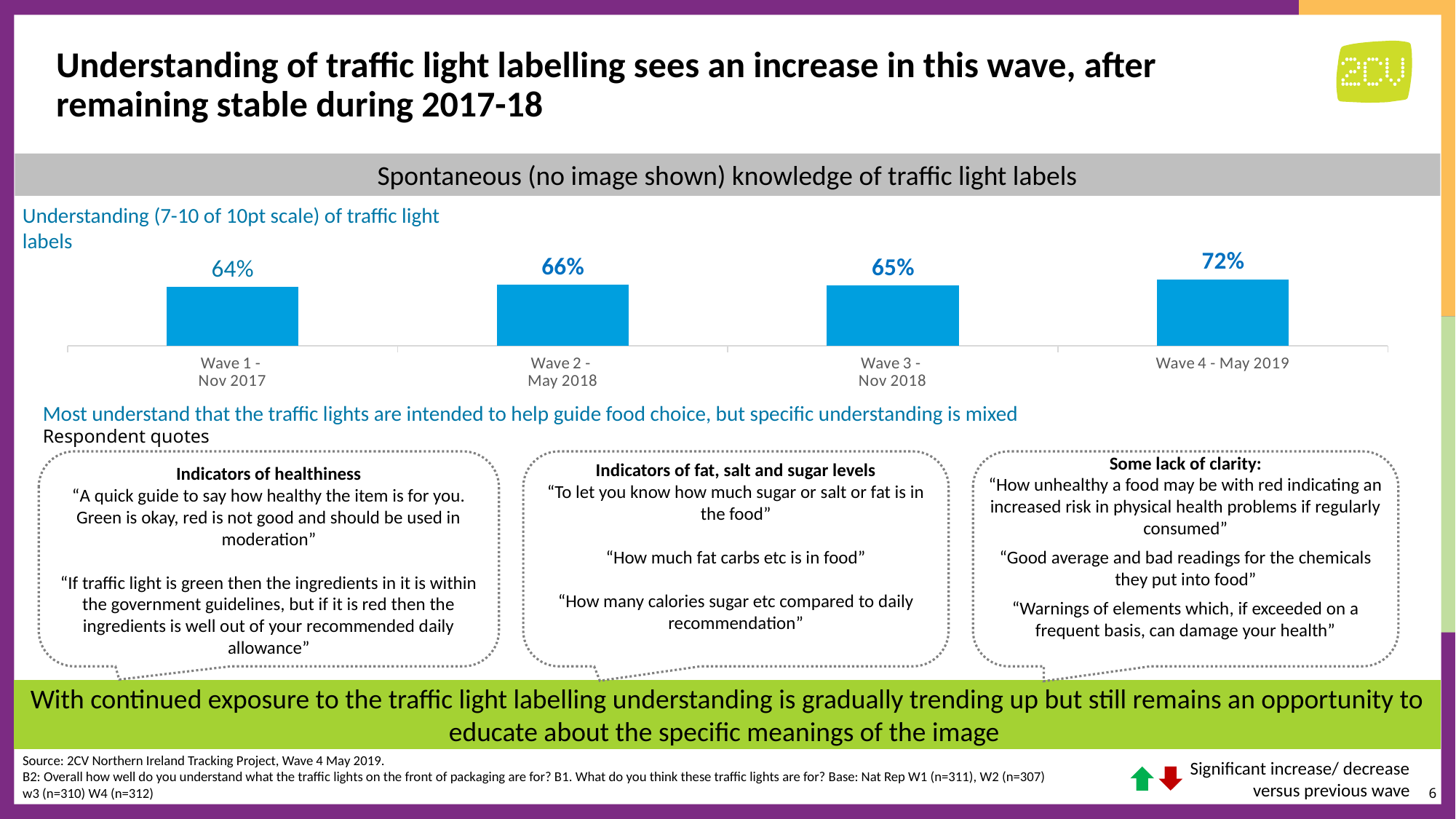
What is the difference between the values for Wave 2 - May 2018 and Wave 1 - Nov 2017? 2% Which is larger, the value for Wave 4 - May 2019 or Wave 1 - Nov 2017? Wave 4 - May 2019 What is the value for Wave 4 - May 2019? 72% What is the difference between the values for Wave 4 - May 2019 and Wave 3 - Nov 2018? 7% What is the value for Wave 2 - May 2018? 66% What is the value for Wave 1 - Nov 2017? 64% Which wave has the highest value? Wave 4 - May 2019 Which wave has the lowest value? Wave 1 - Nov 2017 What is the value for Wave 3 - Nov 2018? 65% What is the subtitle of the chart shown in blue above the bars? Understanding (7-10 of 10pt scale) of traffic light labels How many waves are plotted in the chart? 4 What kind of chart is shown? Bar chart